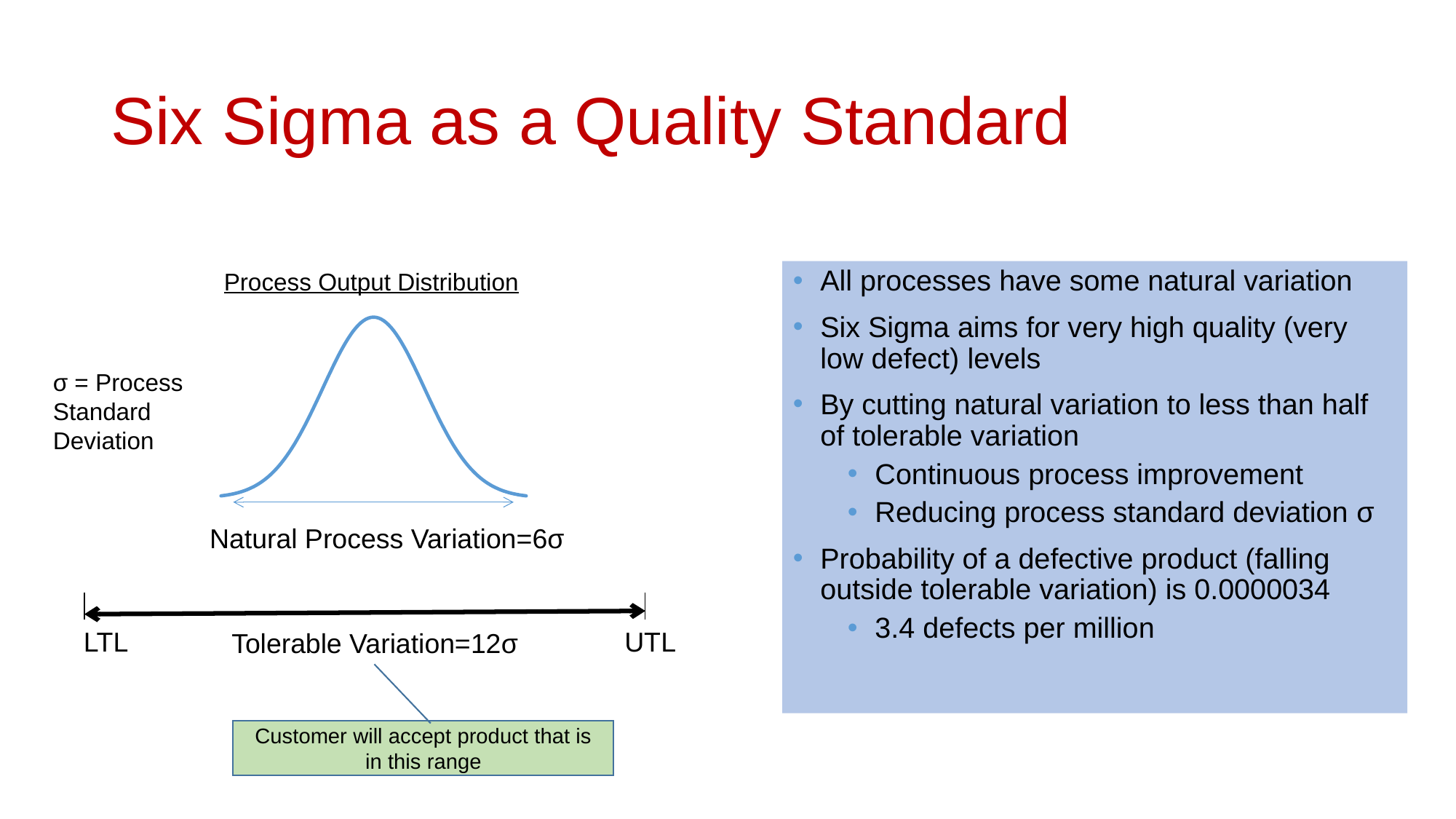
In the Process Output Distribution diagram, what is the Natural Process Variation equal to? 6σ In the Process Output Distribution diagram, what labels mark the two ends of the Tolerable Variation arrow? LTL and UTL What is the title of the curve diagram on the left of the slide? Process Output Distribution What kind of curve is drawn in the Process Output Distribution diagram? A bell-shaped (normal distribution) curve In the Process Output Distribution diagram, what is the Tolerable Variation equal to? 12σ In the Process Output Distribution diagram, which is larger, the Natural Process Variation or the Tolerable Variation? Tolerable Variation